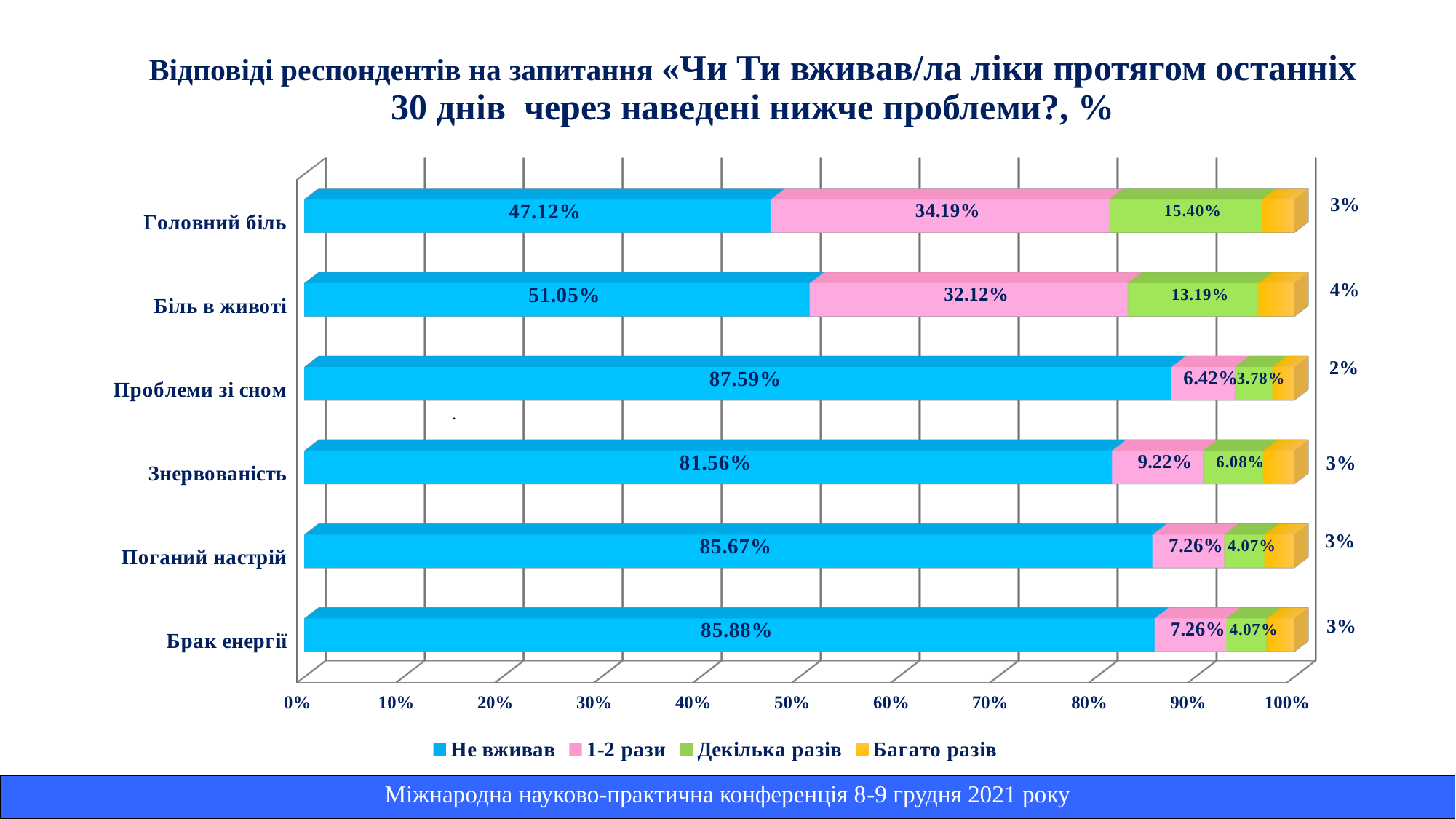
Which is larger: the "Не вживав" value for Поганий настрій or for Брак енергії? Брак енергії What is the "Декілька разів" value for Знервованість? 6.08% How many categories are shown on the chart? 6 What is the "Багато разів" value for Проблеми зі сном? 2% What is the difference between the "1-2 рази" values for Головний біль and Біль в животі? 2.07% What type of chart is shown on the slide? Stacked bar chart Which category has the highest "Багато разів" value? Біль в животі Which category has the highest "Не вживав" value? Проблеми зі сном How many series does the legend list? 4 What percentage of respondents answered "Не вживав" for Головний біль? 47.12% What is the value of the "1-2 рази" segment for Біль в животі? 32.12% Which category has the lowest "Не вживав" value? Головний біль